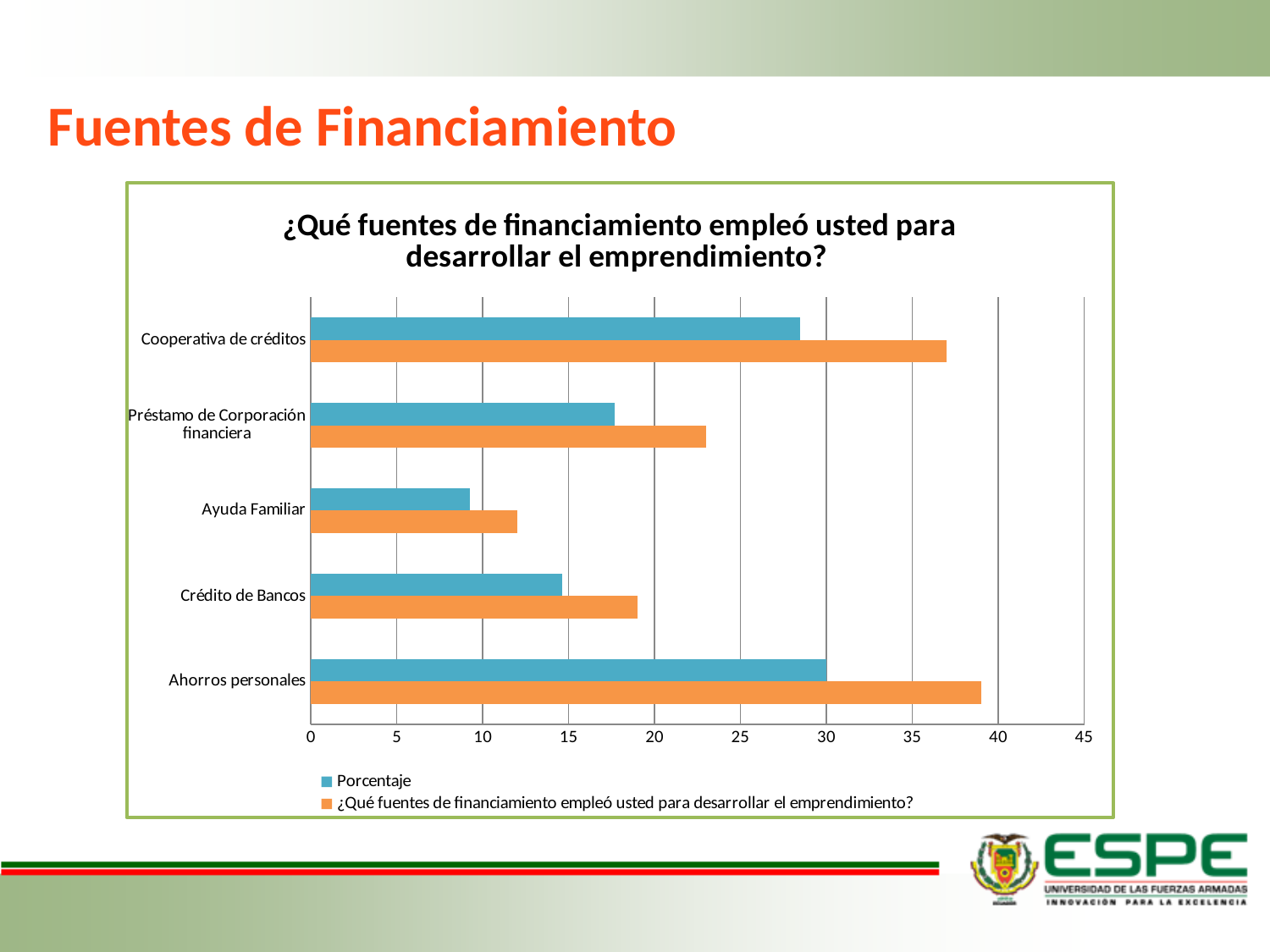
Which category has the lowest Porcentaje value? Ayuda Familiar Is the orange-series value for Cooperativa de créditos greater or less than 35? greater For the orange series, which is larger: Crédito de Bancos or Ayuda Familiar? Crédito de Bancos How many financing source categories are shown on the chart? 5 Is the Porcentaje value for Cooperativa de créditos greater or less than 30? less Is the orange-series value for Ayuda Familiar greater or less than 10? greater Which category has the highest value for the orange series (¿Qué fuentes de financiamiento empleó usted para desarrollar el emprendimiento?)? Ahorros personales Which colour represents the Porcentaje series in the chart? blue What kind of chart is shown on the slide? bar chart Which category has the lowest value for the orange series? Ayuda Familiar How many series does the chart legend list? 2